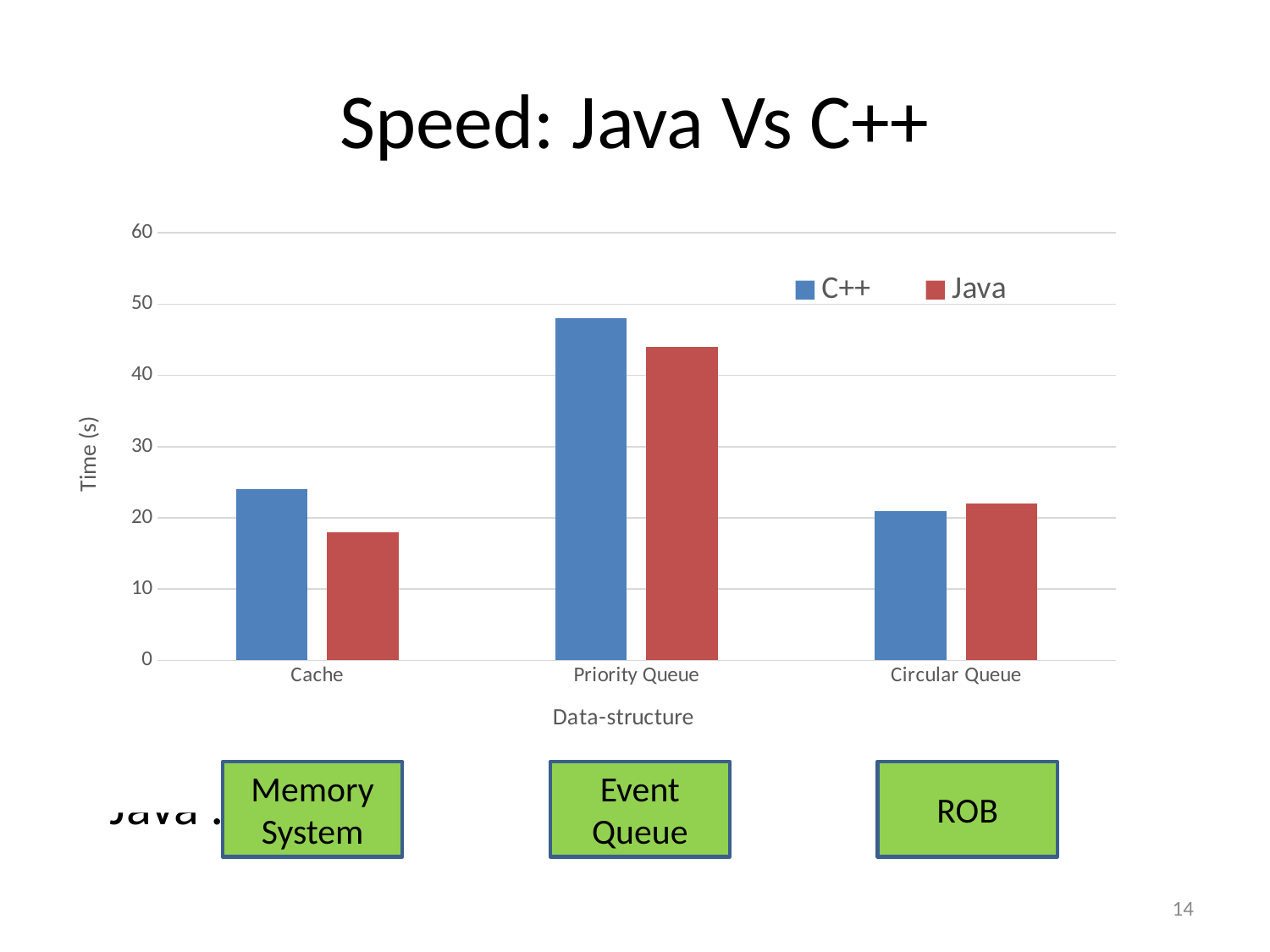
Is the C++ value for Circular Queue greater or less than 30? less What is the label of the y axis? Time (s) For Priority Queue, which is larger, the C++ time or the Java time? C++ How many data-structure categories are shown on the x axis? 3 How many series does the legend list? 2 What kind of chart is shown on the slide? bar chart What colour are the Java bars? red Which data structure has the highest C++ time? Priority Queue For Cache, which is larger, the C++ time or the Java time? C++ Which data structure has the lowest Java time? Cache Is the Java value for Priority Queue greater or less than 40? greater Is the C++ value for Cache greater or less than 20? greater